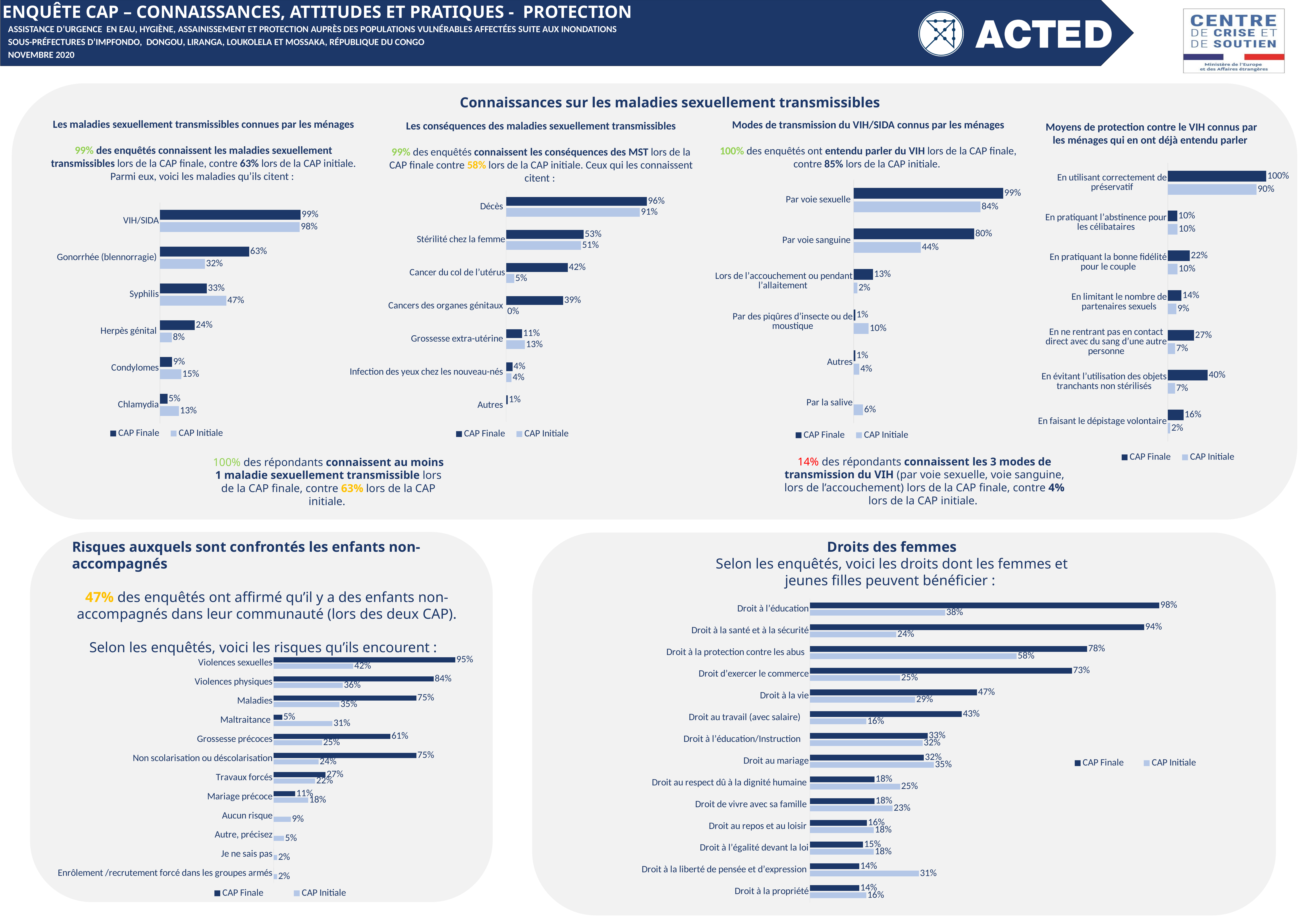
In the chart 'Modes de transmission du VIH/SIDA connus par les ménages', which is larger for 'Par des piqûres d'insecte ou de moustique': CAP Finale or CAP Initiale? CAP Initiale In the chart 'Risques auxquels sont confrontés les enfants non-accompagnés', what is the CAP Finale value for Violences sexuelles? 95% In the chart 'Droits des femmes', which right has the lowest CAP Initiale value? Droit au travail (avec salaire) and Droit à la propriété (both 16%) In the chart 'Les conséquences des maladies sexuellement transmissibles', which consequence has the highest CAP Finale value? Décès In the chart 'Les conséquences des maladies sexuellement transmissibles', what is the CAP Initiale value for Cancer du col de l'utérus? 5% How many series does the legend of the 'Droits des femmes' chart list? 2 In the chart 'Modes de transmission du VIH/SIDA connus par les ménages', what is the CAP Initiale value for Par voie sanguine? 44% In the chart 'Les maladies sexuellement transmissibles connues par les ménages', what is the difference between the CAP Initiale and CAP Finale values for Syphilis? 14% In the chart 'Moyens de protection contre le VIH connus par les ménages qui en ont déjà entendu parler', what is the CAP Finale value for 'En évitant l'utilisation des objets tranchants non stérilisés'? 40% In the chart 'Moyens de protection contre le VIH connus par les ménages qui en ont déjà entendu parler', how many categories are shown? 7 In the chart 'Les maladies sexuellement transmissibles connues par les ménages', what is the CAP Finale value for Gonorrhée (blennorragie)? 63% In the chart 'Risques auxquels sont confrontés les enfants non-accompagnés', what is the difference between the CAP Finale and CAP Initiale values for Non scolarisation ou déscolarisation? 51%